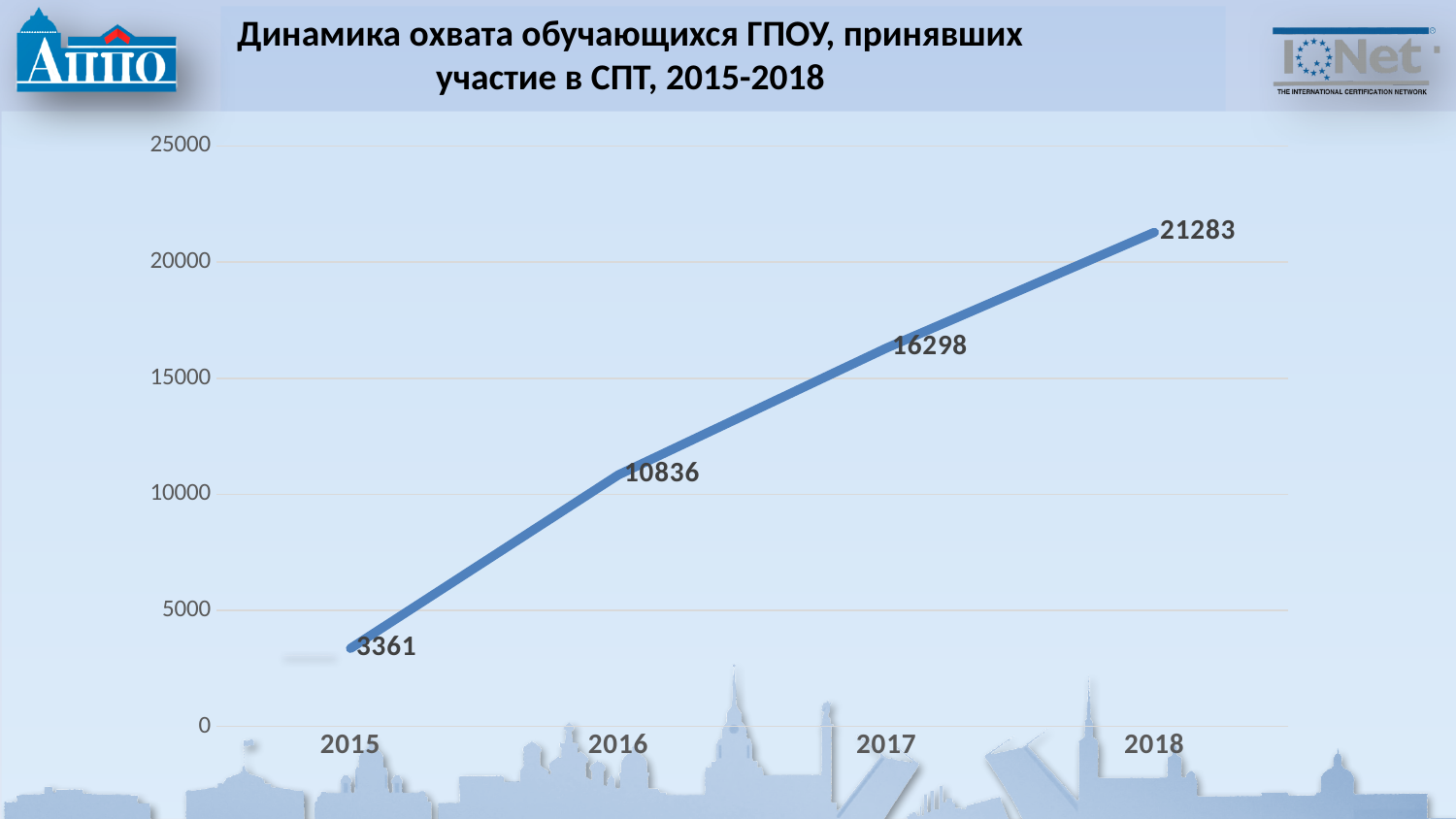
Do the values rise or fall from 2015 to 2018? rise What is the difference between the values for 2016 and 2015? 7475 What is the difference between the values for 2018 and 2017? 4985 What kind of chart is shown on the slide? line chart Which year has the highest value? 2018 What is the value for 2015? 3361 Which is larger, the value for 2016 or the value for 2017? 2017 What is the value for 2016? 10836 Which year has the lowest value? 2015 What is the value for 2017? 16298 What is the value for 2018? 21283 How many data points are plotted on the chart? 4